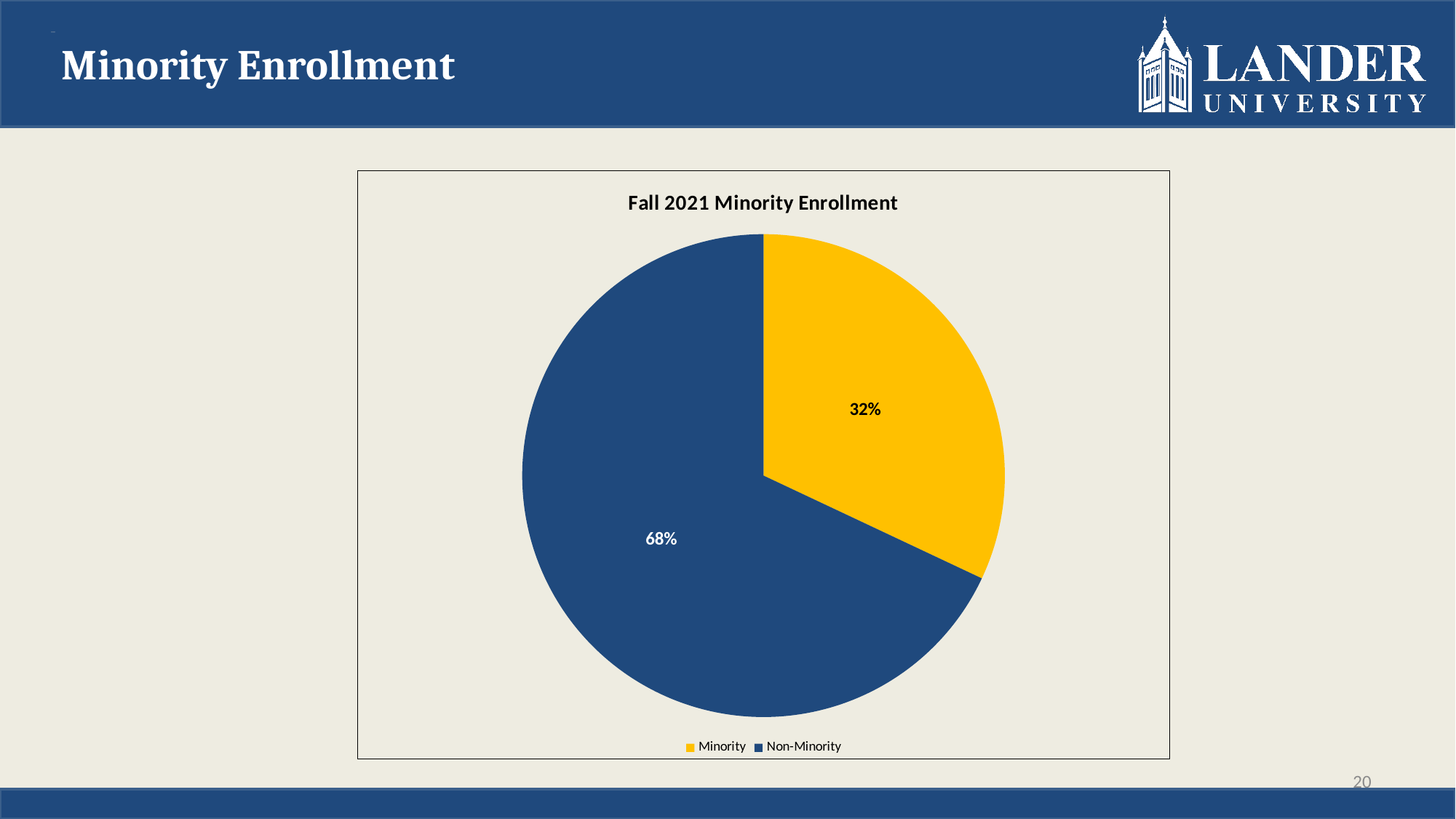
What is the difference in percentage points between the Non-Minority and Minority slices? 36 Which slice is the largest? Non-Minority What colour is the Minority slice? yellow What is the title of the chart? Fall 2021 Minority Enrollment What percentage of the pie is the Non-Minority slice? 68% How many slices does the pie chart have? 2 How many entries does the legend list? 2 What kind of chart is shown on the slide? pie chart What share of the pie does the Non-Minority slice represent? 68% What percentage of the pie is the Minority slice? 32% Which is larger, the Minority slice or the Non-Minority slice? Non-Minority Which slice is the smallest? Minority